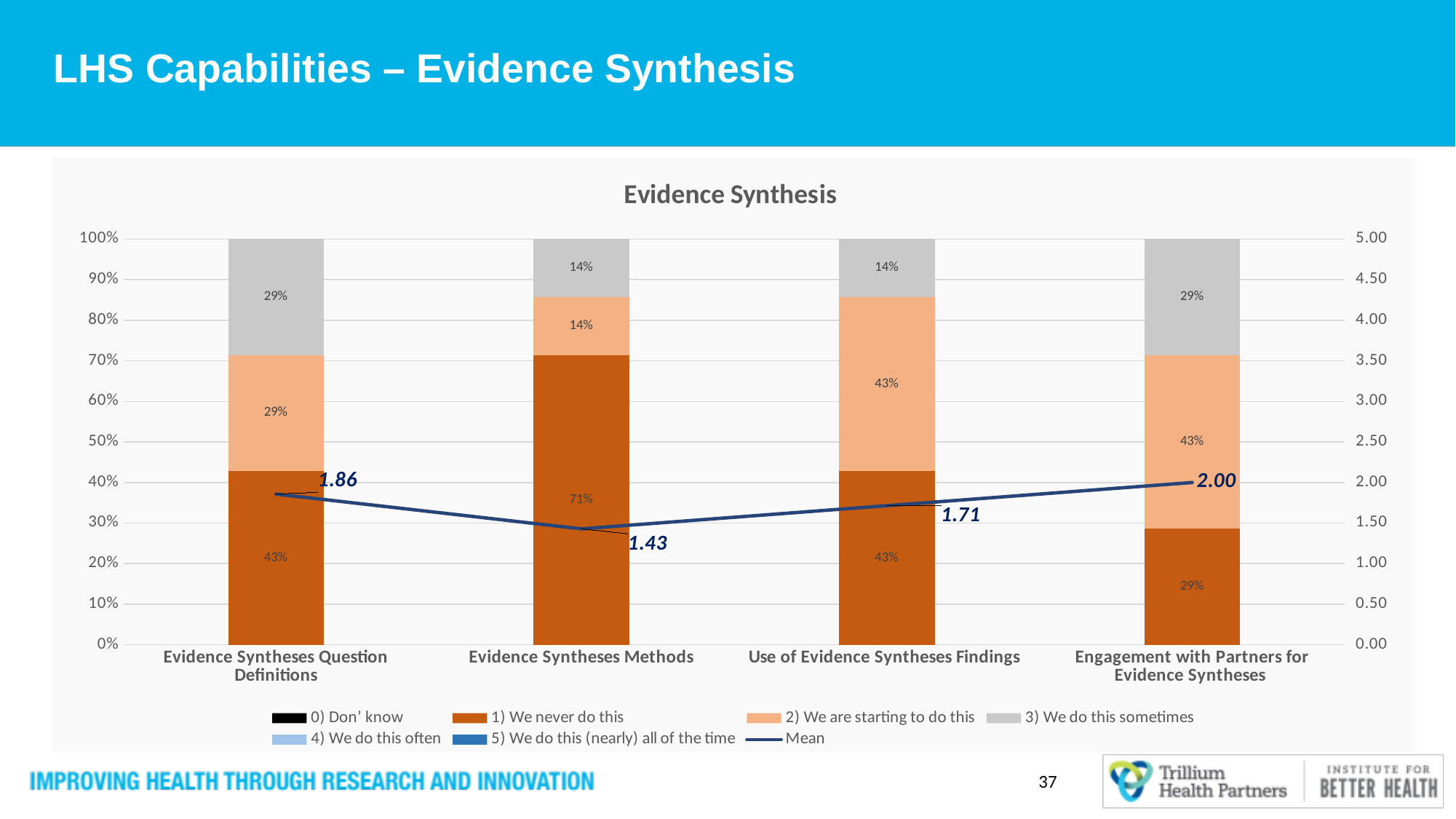
Which category has the highest Mean value? Engagement with Partners for Evidence Syntheses What is the Mean value for Engagement with Partners for Evidence Syntheses? 2.00 What percentage of respondents answered '1) We never do this' for Evidence Syntheses Methods? 71% How many entries does the legend list? 7 What percentage of respondents answered '3) We do this sometimes' for Evidence Syntheses Question Definitions? 29% What kind of chart is shown on the slide? Stacked bar chart with a line for the mean How many categories are shown on the x axis? 4 Which category has the lowest Mean value? Evidence Syntheses Methods What is the difference between the Mean for Engagement with Partners for Evidence Syntheses and the Mean for Evidence Syntheses Methods? 0.57 What is the chart's title? Evidence Synthesis What percentage of respondents answered '2) We are starting to do this' for Use of Evidence Syntheses Findings? 43% Which has a larger '1) We never do this' share: Evidence Syntheses Question Definitions or Engagement with Partners for Evidence Syntheses? Evidence Syntheses Question Definitions